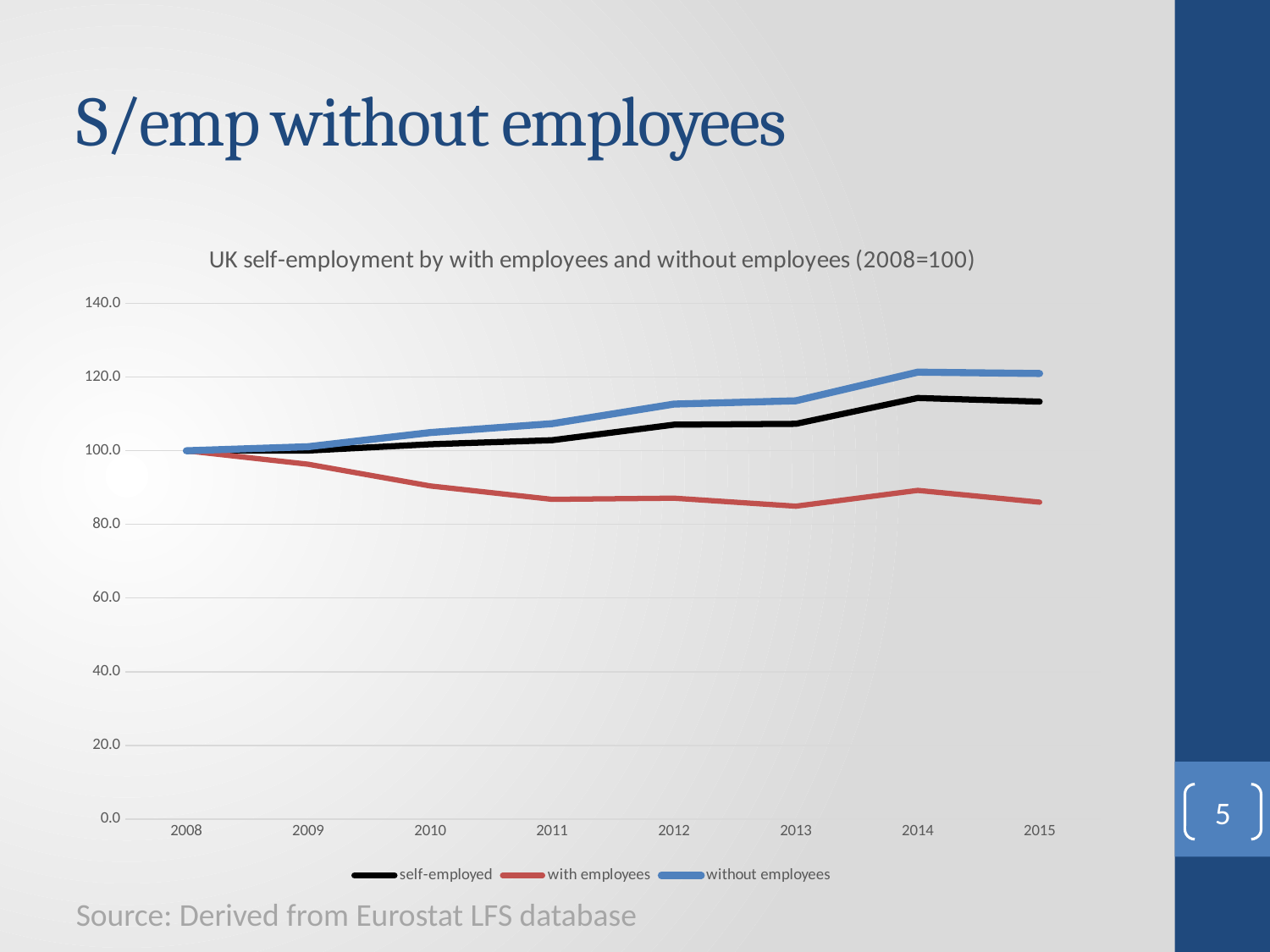
How many years are plotted along the x axis? 8 What is the value of the 'without employees' series in 2008? 100.0 Is the value for 'self-employed' in 2015 greater or less than 100? greater In 2015, which is larger: the 'self-employed' series or the 'with employees' series? self-employed Which series has the lowest value in 2015? with employees What is the title of the chart? UK self-employment by with employees and without employees (2008=100) Does the 'with employees' series rise or fall from 2008 to 2015? fall How many series does the legend list? 3 Which series has the highest value in 2015? without employees Does the 'without employees' series rise or fall from 2008 to 2015? rise Is the value for 'with employees' in 2013 greater or less than 100? less What kind of chart is shown on the slide? line chart